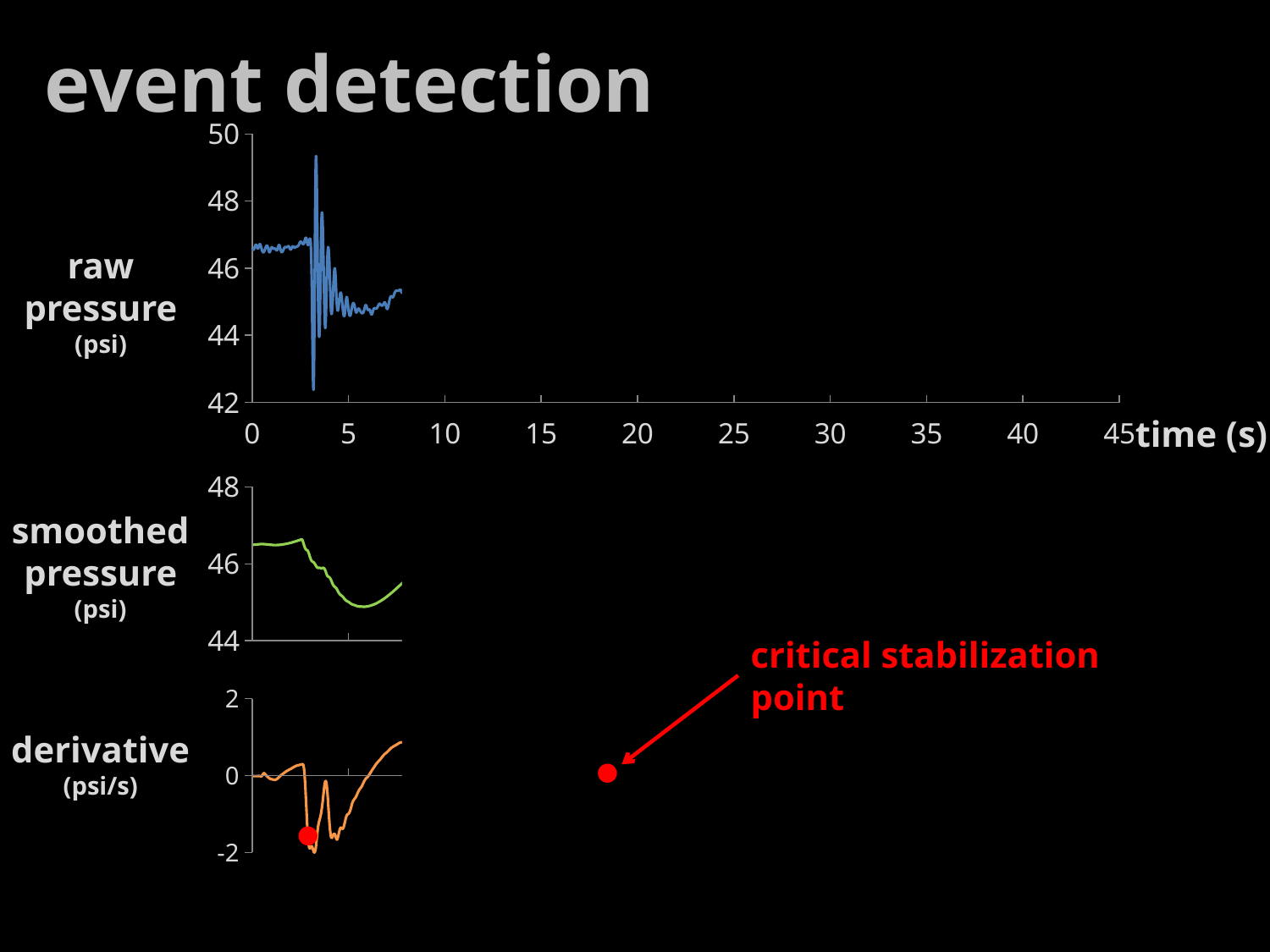
In the smoothed pressure chart, is the lowest point of the line greater or less than 46? less In the raw pressure chart, is the lowest dip greater or less than 44? less What kind of chart is the derivative chart? line chart What is the unit shown for the derivative chart's y axis? psi/s In the derivative chart, is the lowest point of the line greater or less than 0? less In the smoothed pressure chart, does the line rise or fall between time 0 and time 5? fall How many charts are shown on the slide? 3 What is the label of the x axis on the raw pressure chart? time (s) What kind of chart is the raw pressure chart? line chart